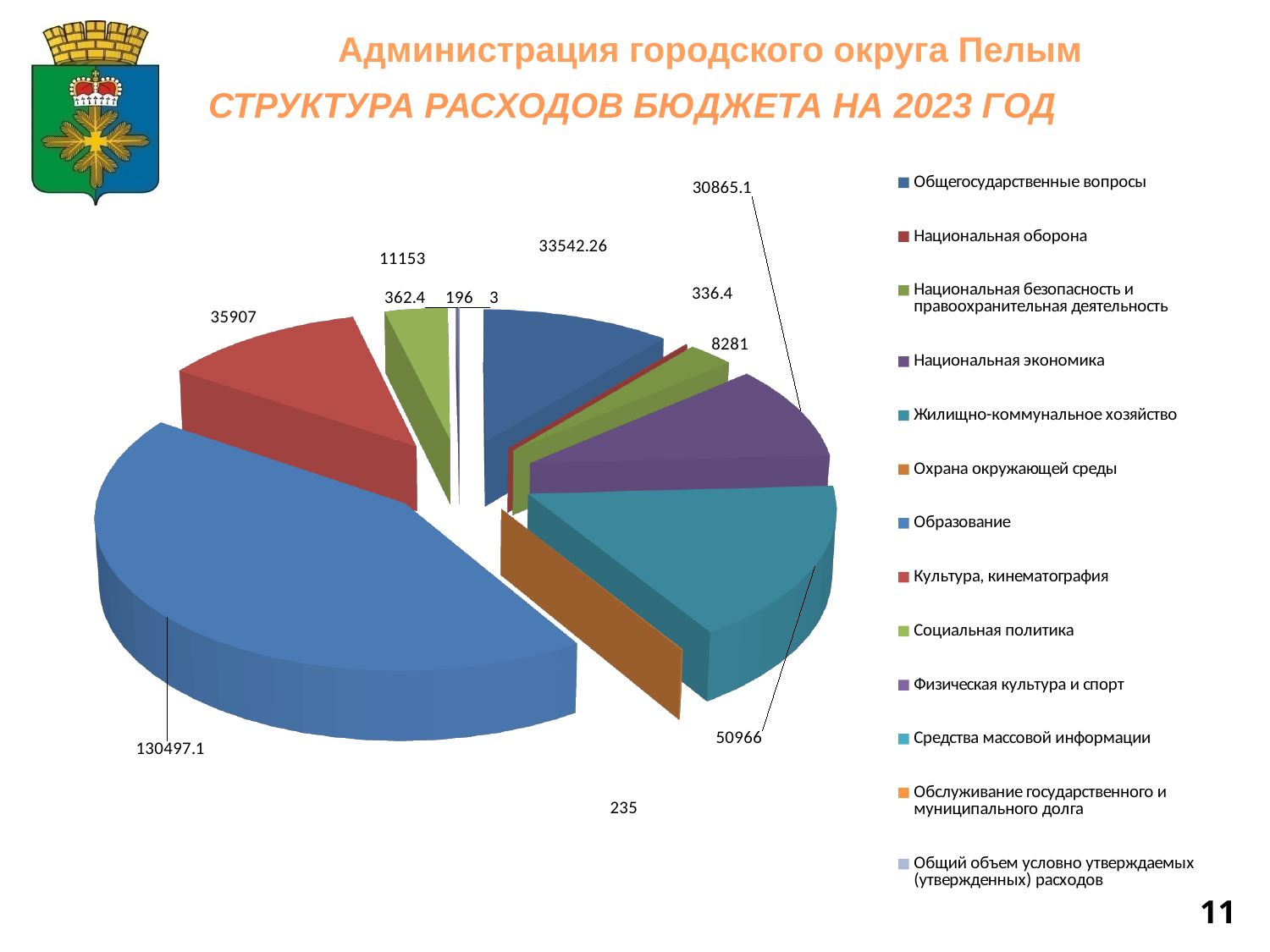
What is the title of the chart? СТРУКТУРА РАСХОДОВ БЮДЖЕТА НА 2023 ГОД What is the value shown for Общегосударственные вопросы? 33542.26 What is the value shown for Культура, кинематография? 35907 What is the difference between the values for Образование and Жилищно-коммунальное хозяйство? 79531.1 What is the value shown for Национальная экономика? 30865.1 What is the value shown for Жилищно-коммунальное хозяйство? 50966 Which category has the largest slice of the pie? Образование What is the smallest data label value shown on the chart? 3 What kind of chart is shown on the slide? pie chart How many entries does the legend list? 13 Which is larger, the value for Культура, кинематография or the value for Общегосударственные вопросы? Культура, кинематография What is the value shown for Образование? 130497.1